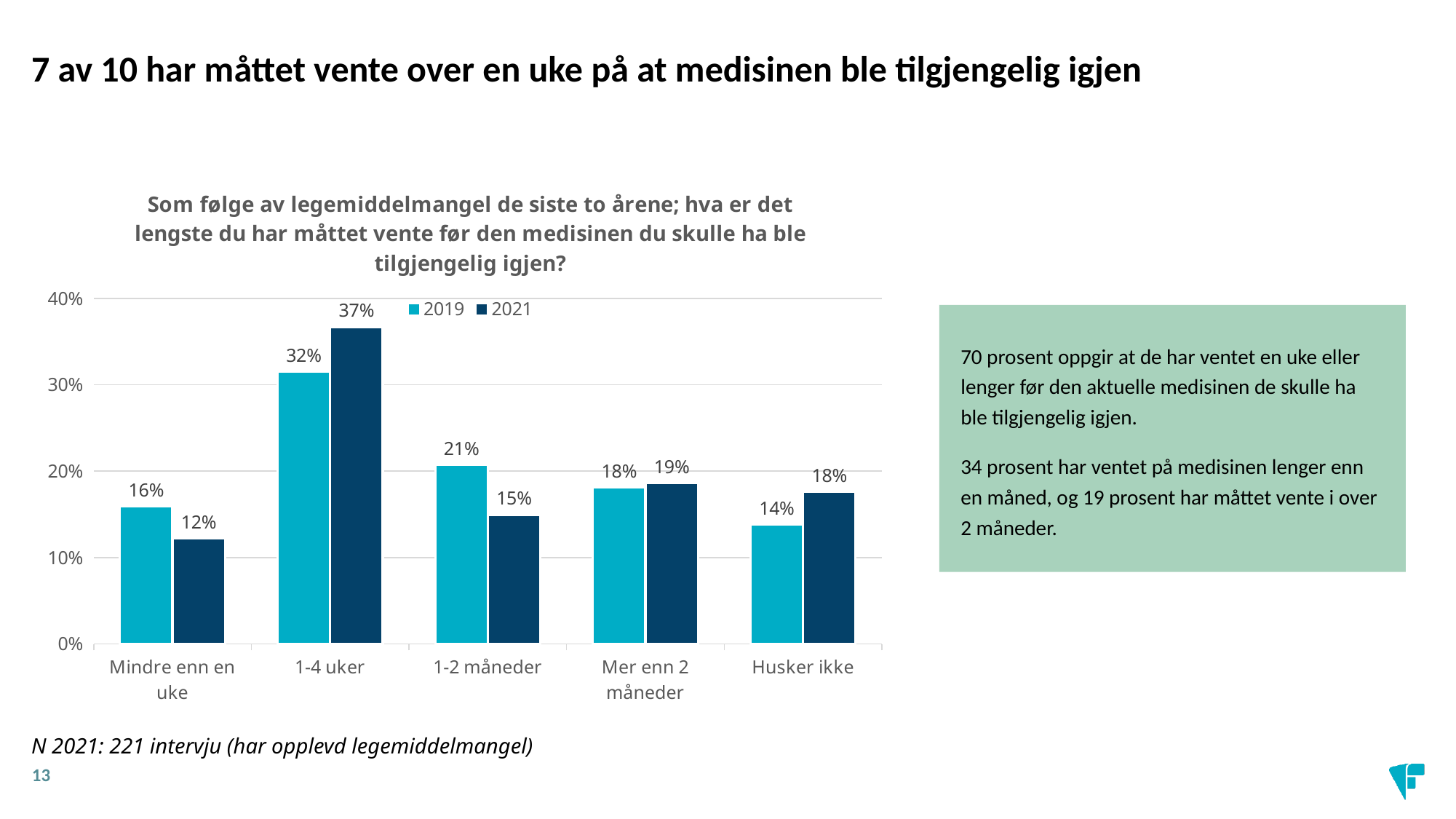
Which is larger for "Husker ikke": the 2019 value or the 2021 value? 2021 What is the 2019 value for "1-2 måneder"? 21% What is the difference between the 2019 and 2021 values for "1-2 måneder"? 6% Which category has the highest 2019 value? 1-4 uker How many series does the legend list? 2 What kind of chart is shown on the slide? Bar chart Is the 2019 value for "1-4 uker" greater or less than 30%? greater Which category has the lowest 2021 value? Mindre enn en uke How many categories are shown on the x axis? 5 Which series is shown in dark blue? 2021 What is the 2021 value for "1-4 uker"? 37% What is the 2021 value for "Mindre enn en uke"? 12%